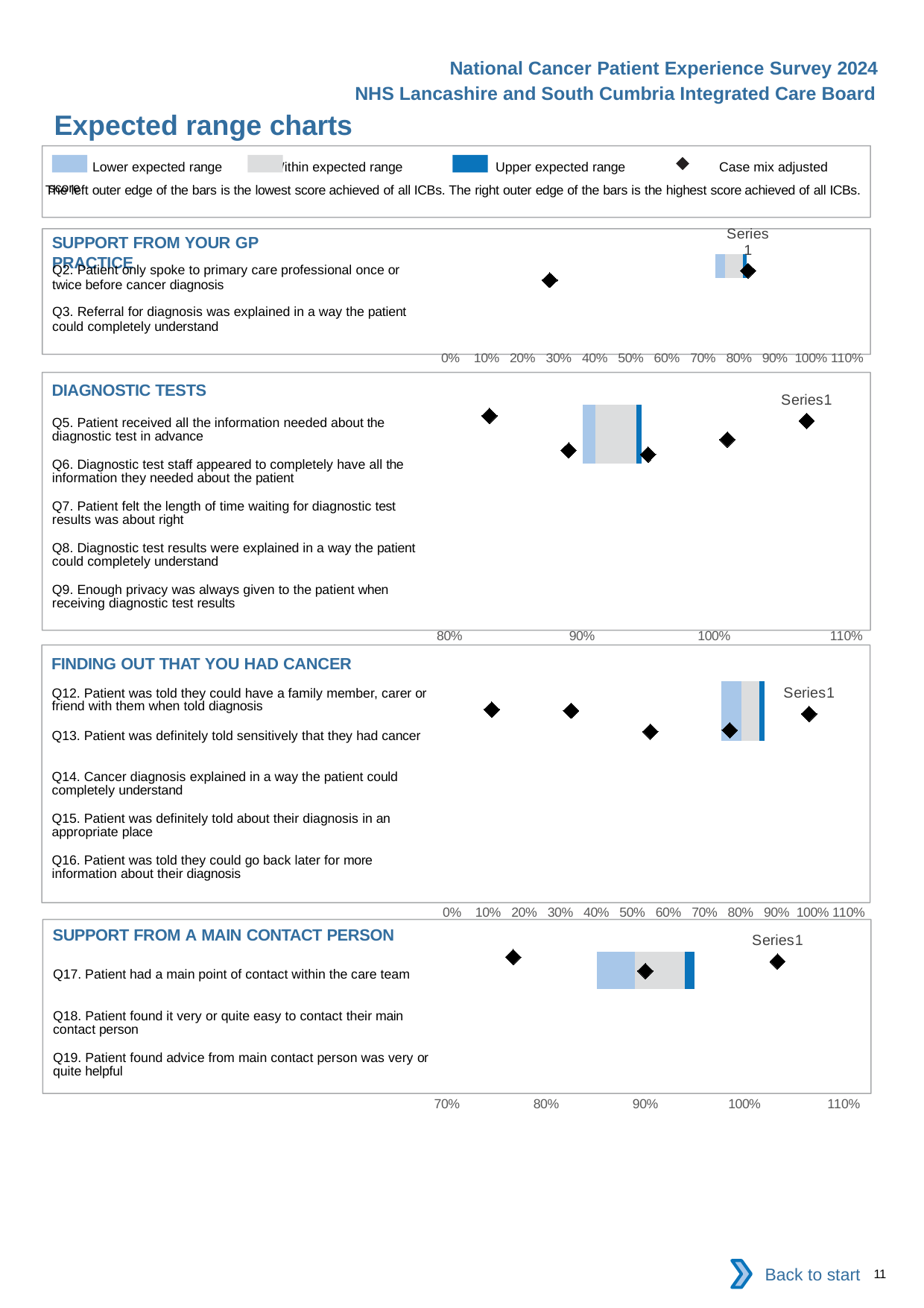
In the FINDING OUT THAT YOU HAD CANCER chart, how many diamond markers are plotted? 5 What kind of chart is the DIAGNOSTIC TESTS chart? Horizontal bar chart with diamond markers What is the lowest x-axis tick label on the SUPPORT FROM A MAIN CONTACT PERSON chart? 70% In the SUPPORT FROM A MAIN CONTACT PERSON chart, how many diamond markers are plotted? 3 In the SUPPORT FROM YOUR GP PRACTICE chart, is the leftmost diamond marker greater or less than 40%? less In the FINDING OUT THAT YOU HAD CANCER chart, is the leftmost diamond marker greater or less than 20%? less In the DIAGNOSTIC TESTS chart, how many questions are listed on the left? 5 In the SUPPORT FROM A MAIN CONTACT PERSON chart, is the leftmost diamond marker greater or less than 80%? less